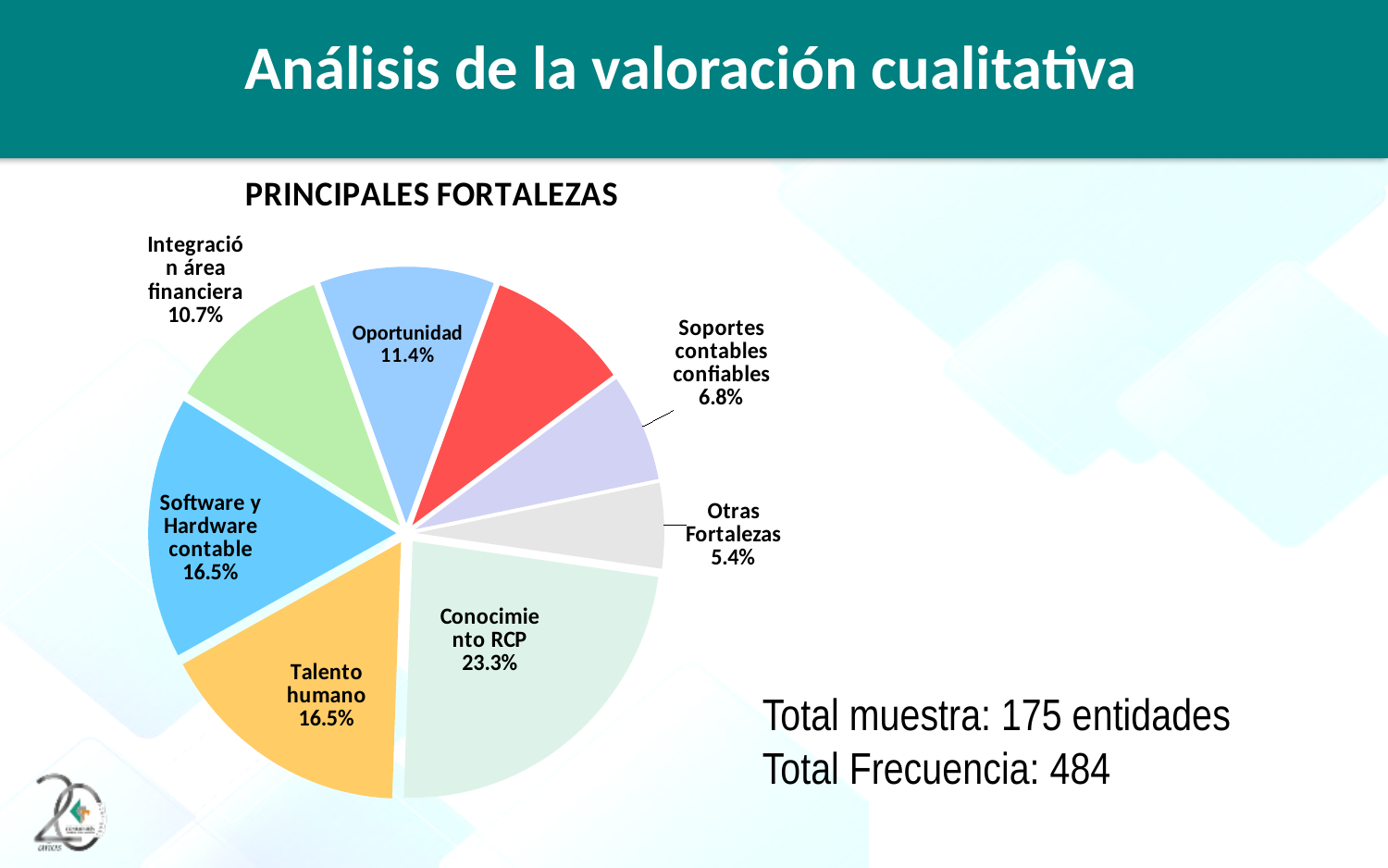
Which category has the largest slice of the pie? Conocimiento RCP What percentage is shown for Soportes contables confiables? 6.8% Which labeled category has the smallest slice of the pie? Otras Fortalezas What is the title of the chart? PRINCIPALES FORTALEZAS How many slices does the pie chart have? 8 Which is larger, the slice for Oportunidad or the slice for Integración área financiera? Oportunidad What type of chart is shown on the slide? Pie chart What percentage is shown for Conocimiento RCP? 23.3% What percentage is shown for Integración área financiera? 10.7% What share of the pie does Software y Hardware contable represent? 16.5% What percentage is shown for Oportunidad? 11.4% What is the difference in percentage points between Conocimiento RCP and Talento humano? 6.8